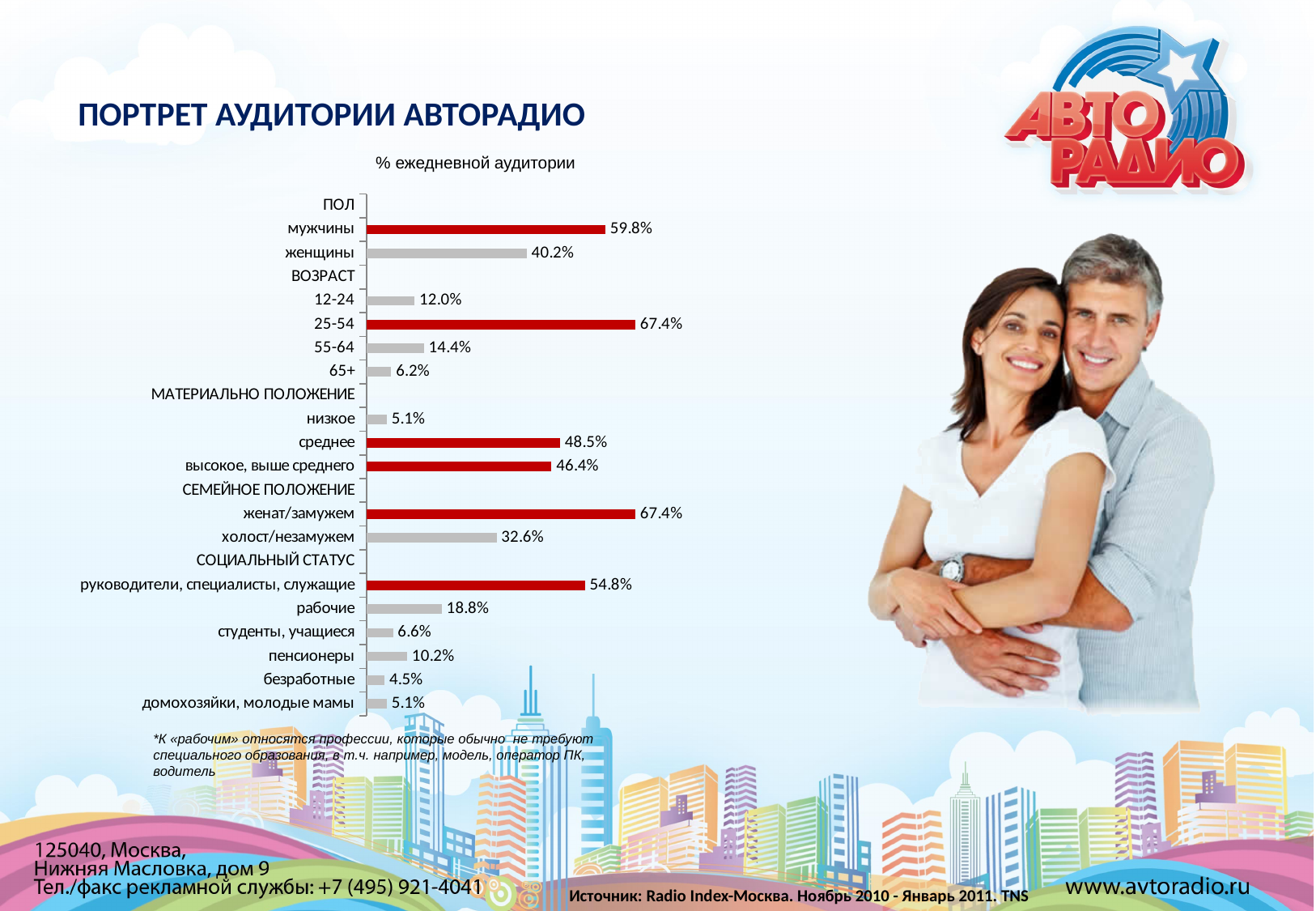
Which is larger, the value for рабочие or the value for студенты, учащиеся? рабочие Among the age groups (12-24, 25-54, 55-64, 65+), which has the highest value? 25-54 How many bars with values are plotted on the chart? 17 Which category has the lowest value on the chart? безработные What is the subtitle shown above the chart? % ежедневной аудитории What is the value for мужчины? 59.8% What is the difference between the values for среднее and высокое, выше среднего? 2.1% What is the value for пенсионеры? 10.2% What is the difference between the values for мужчины and женщины? 19.6% What is the value for the 25-54 age group? 67.4% What type of chart is shown on the slide? bar chart What is the value for холост/незамужем? 32.6%